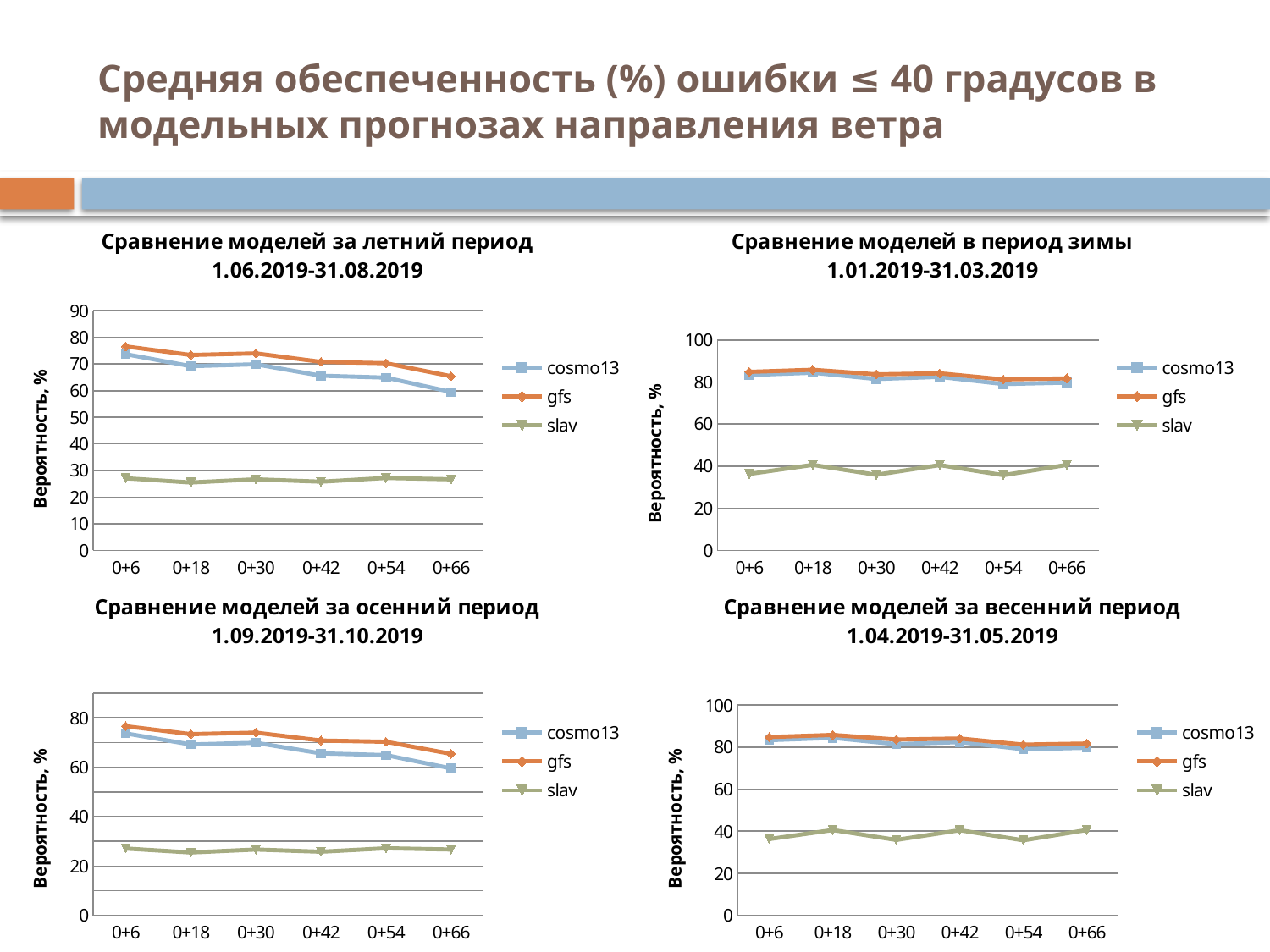
What is the y-axis label of the bottom-right chart 'Сравнение моделей за весенний период 1.04.2019-31.05.2019'? Вероятность, % In the bottom-left chart 'Сравнение моделей за осенний период', is the value for slav at 0+42 greater or less than 40? less In the top-right chart 'Сравнение моделей в период зимы', is the value for gfs at 0+6 greater or less than 80? greater In the top-left chart 'Сравнение моделей за летний период', is the value for slav at 0+6 greater or less than 30? less What kind of chart is the top-left chart 'Сравнение моделей за летний период 1.06.2019-31.08.2019'? line chart How many points along the x axis does the bottom-left chart 'Сравнение моделей за осенний период 1.09.2019-31.10.2019' have? 6 In the top-left chart 'Сравнение моделей за летний период', which series has the lowest values? slav In the top-left chart 'Сравнение моделей за летний период', which is larger at 0+66: cosmo13 or gfs? gfs In the top-left chart 'Сравнение моделей за летний период', do the values for cosmo13 rise or fall from 0+6 to 0+66? fall How many series does the legend of the top-right chart 'Сравнение моделей в период зимы 1.01.2019-31.03.2019' list? 3 In the top-right chart 'Сравнение моделей в период зимы', which series has the lowest values? slav